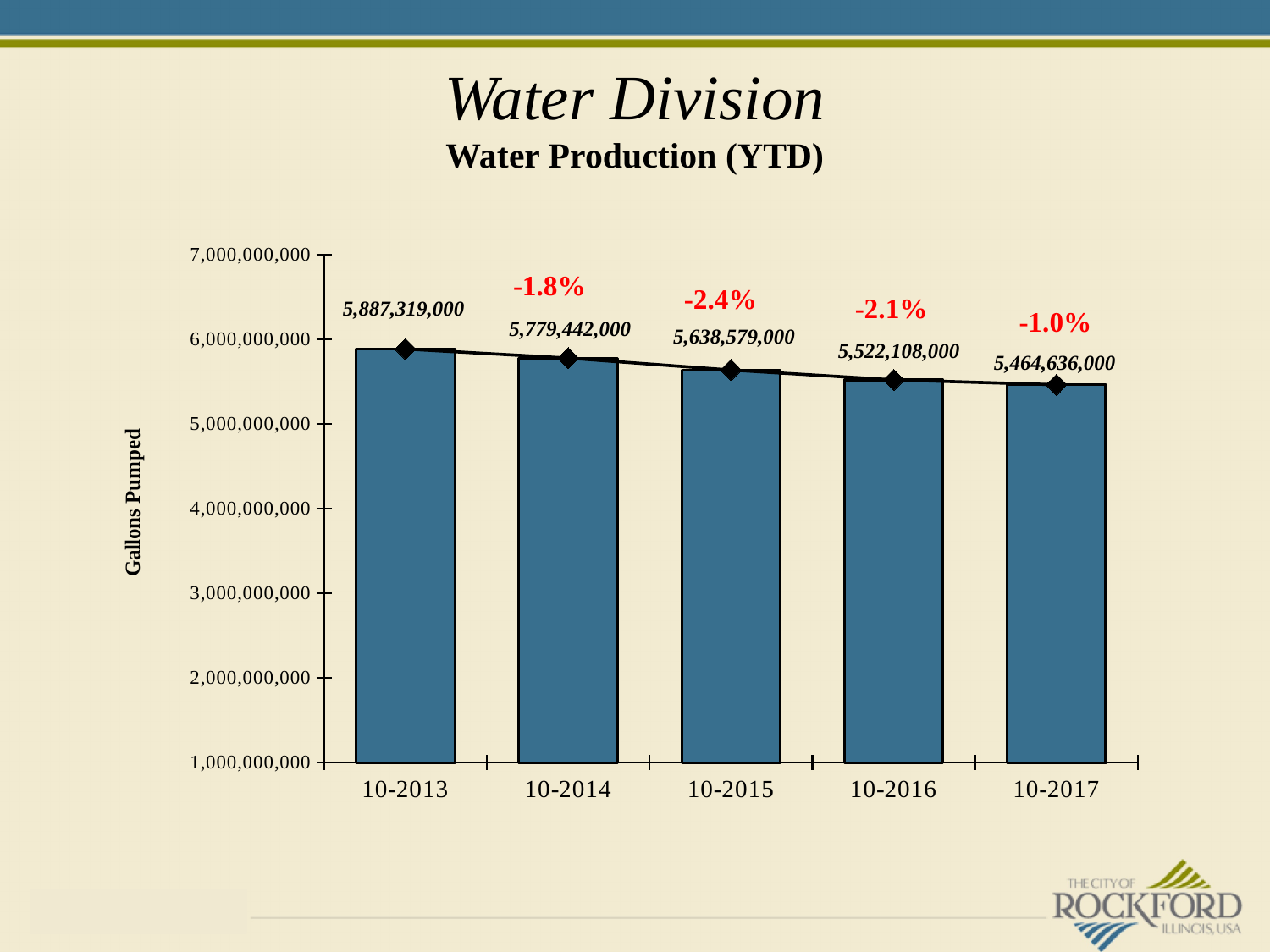
What percentage change is shown above the 10-2015 bar? -2.4% What is the value for 10-2013? 5,887,319,000 Which year has the lowest value? 10-2017 What is the y-axis label of the chart? Gallons Pumped What is the value for 10-2015? 5,638,579,000 What is the difference between the values for 10-2013 and 10-2014? 107,877,000 Which year has the highest value? 10-2013 What is the difference between the values for 10-2013 and 10-2017? 422,683,000 Do the values rise or fall from 10-2013 to 10-2017? fall Which is larger, the value for 10-2014 or the value for 10-2016? 10-2014 What is the value for 10-2017? 5,464,636,000 How many years are shown on the x axis? 5